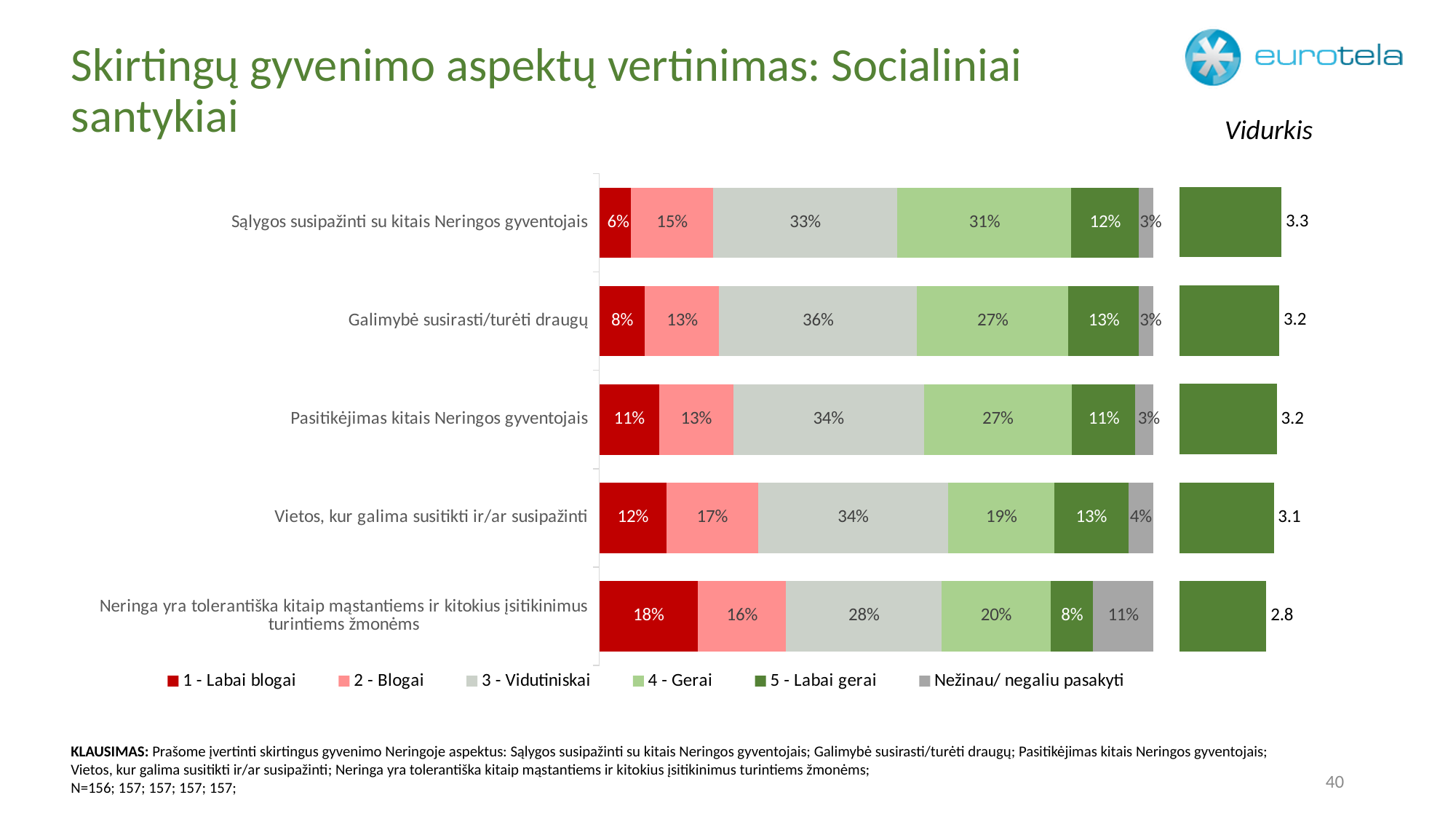
In the stacked bar chart, which is larger: the '2 - Blogai' share for 'Vietos, kur galima susitikti ir/ar susipažinti' or for 'Pasitikėjimas kitais Neringos gyventojais'? Vietos, kur galima susitikti ir/ar susipažinti How many categories are shown in the stacked bar chart? 5 What type of chart is used to show the rating distributions on this slide? Stacked bar chart In the 'Vidurkis' chart, which category has the highest average? Sąlygos susipažinti su kitais Neringos gyventojais In the stacked bar chart, what is the 'Nežinau/ negaliu pasakyti' share for 'Vietos, kur galima susitikti ir/ar susipažinti'? 4% In the stacked bar chart, what is the '1 - Labai blogai' share for 'Neringa yra tolerantiška kitaip mąstantiems ir kitokius įsitikinimus turintiems žmonėms'? 18% How many series does the legend of the stacked bar chart list? 6 In the 'Vidurkis' chart, which category has the lowest average? Neringa yra tolerantiška kitaip mąstantiems ir kitokius įsitikinimus turintiems žmonėms In the stacked bar chart, what is the difference between the '3 - Vidutiniskai' shares for 'Galimybė susirasti/turėti draugų' and 'Neringa yra tolerantiška kitaip mąstantiems ir kitokius įsitikinimus turintiems žmonėms'? 8% In the stacked bar chart, what percentage of respondents rated 'Sąlygos susipažinti su kitais Neringos gyventojais' as '3 - Vidutiniskai'? 33% In the stacked bar chart, which category has the largest '4 - Gerai' share? Sąlygos susipažinti su kitais Neringos gyventojais In the 'Vidurkis' chart, what is the average for 'Galimybė susirasti/turėti draugų'? 3.2